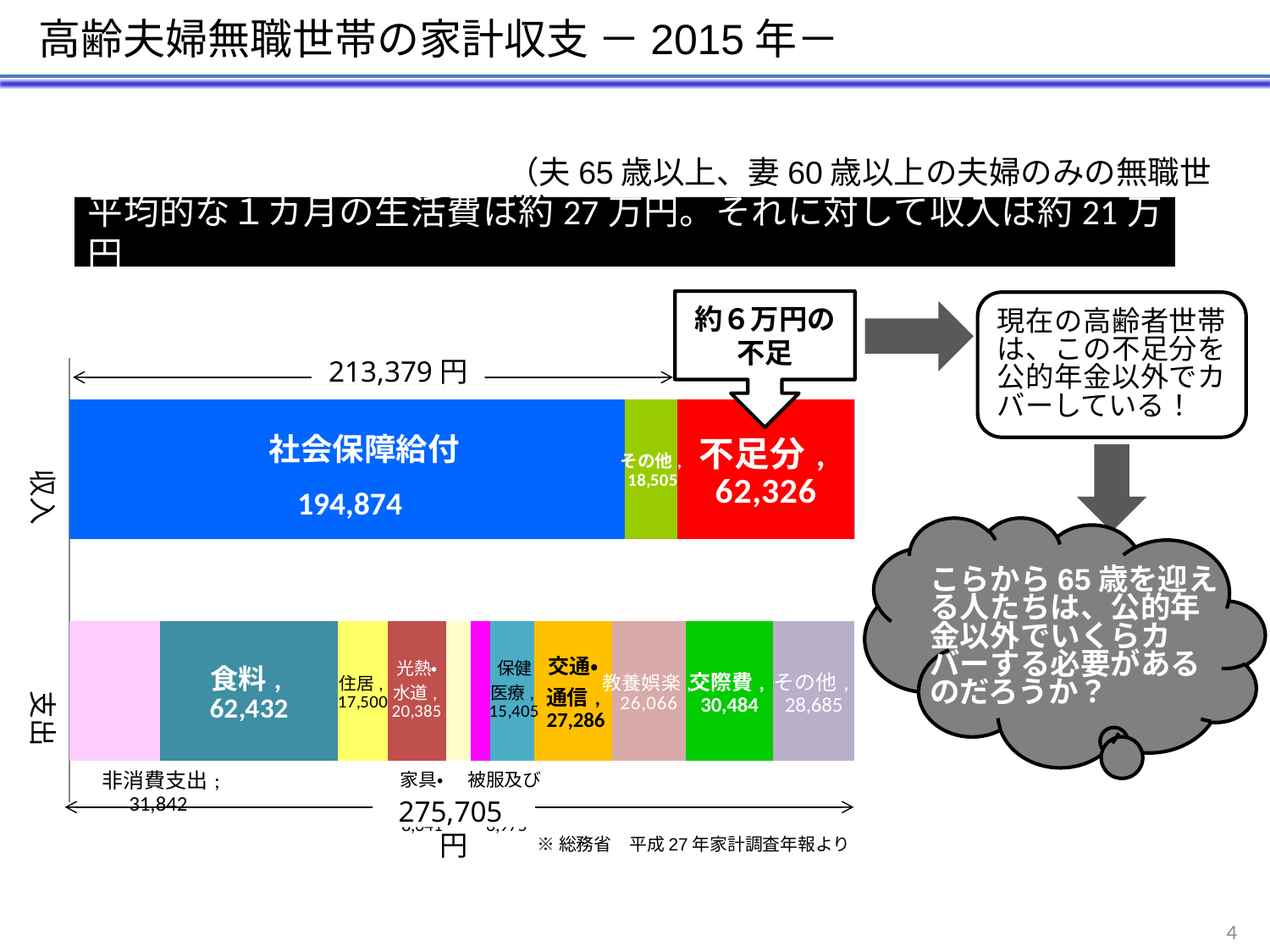
In the 収入 bar, what is the value for 社会保障給付? 194,874 In the 支出 bar, what is the value for 交際費? 30,484 In the 支出 bar, what is the value for 交通・通信? 27,286 Which segment of the 支出 bar is the largest? 食料 What is the total of the 支出 bar as labelled on the slide? 275,705円 Which is larger in the 支出 bar, 教養娯楽 or 住居? 教養娯楽 What is the difference between 食料 (62,432) and 交際費 (30,484) in the 支出 bar? 31,948 In the 収入 bar, what is the value for その他? 18,505 What type of chart is shown on the slide? stacked bar chart In the 収入 bar, what is the value for 不足分? 62,326 In the 支出 bar, what is the value for 非消費支出? 31,842 In the 支出 bar, what is the value for 食料? 62,432